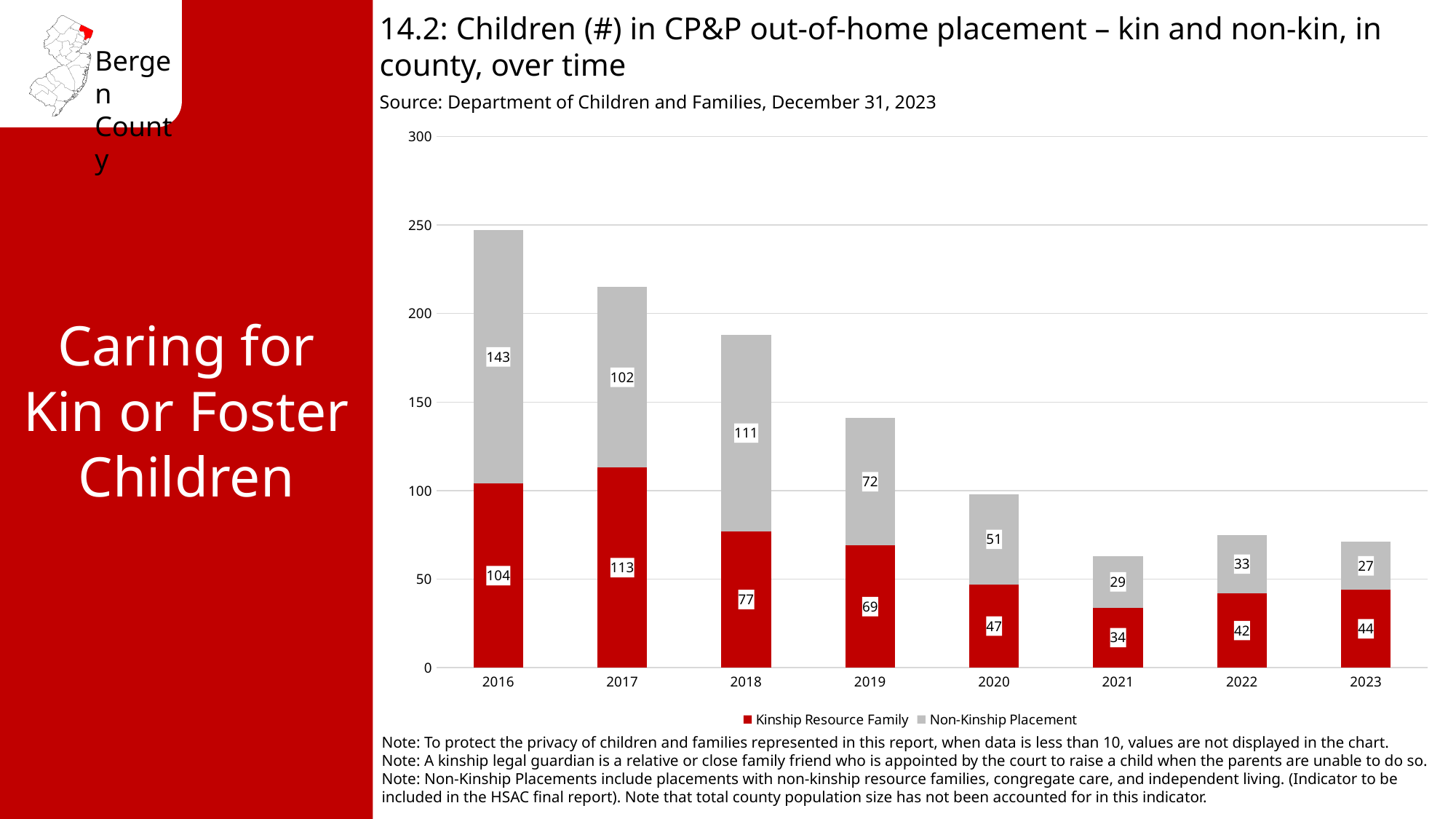
What is the difference between the Non-Kinship Placement values for 2017 and 2018? 9 What is the Kinship Resource Family value for 2016? 104 Which year has the highest Non-Kinship Placement value? 2016 Which is larger, the Kinship Resource Family value for 2022 or for 2023? 2023 What kind of chart is shown? Stacked bar chart How many years are shown on the x axis? 8 Which year has the lowest Kinship Resource Family value? 2021 What is the Non-Kinship Placement value for 2019? 72 What is the total of the stacked bar for 2020? 98 What is the total of the stacked bar for 2016? 247 What is the Kinship Resource Family value for 2023? 44 How many series does the legend list? 2